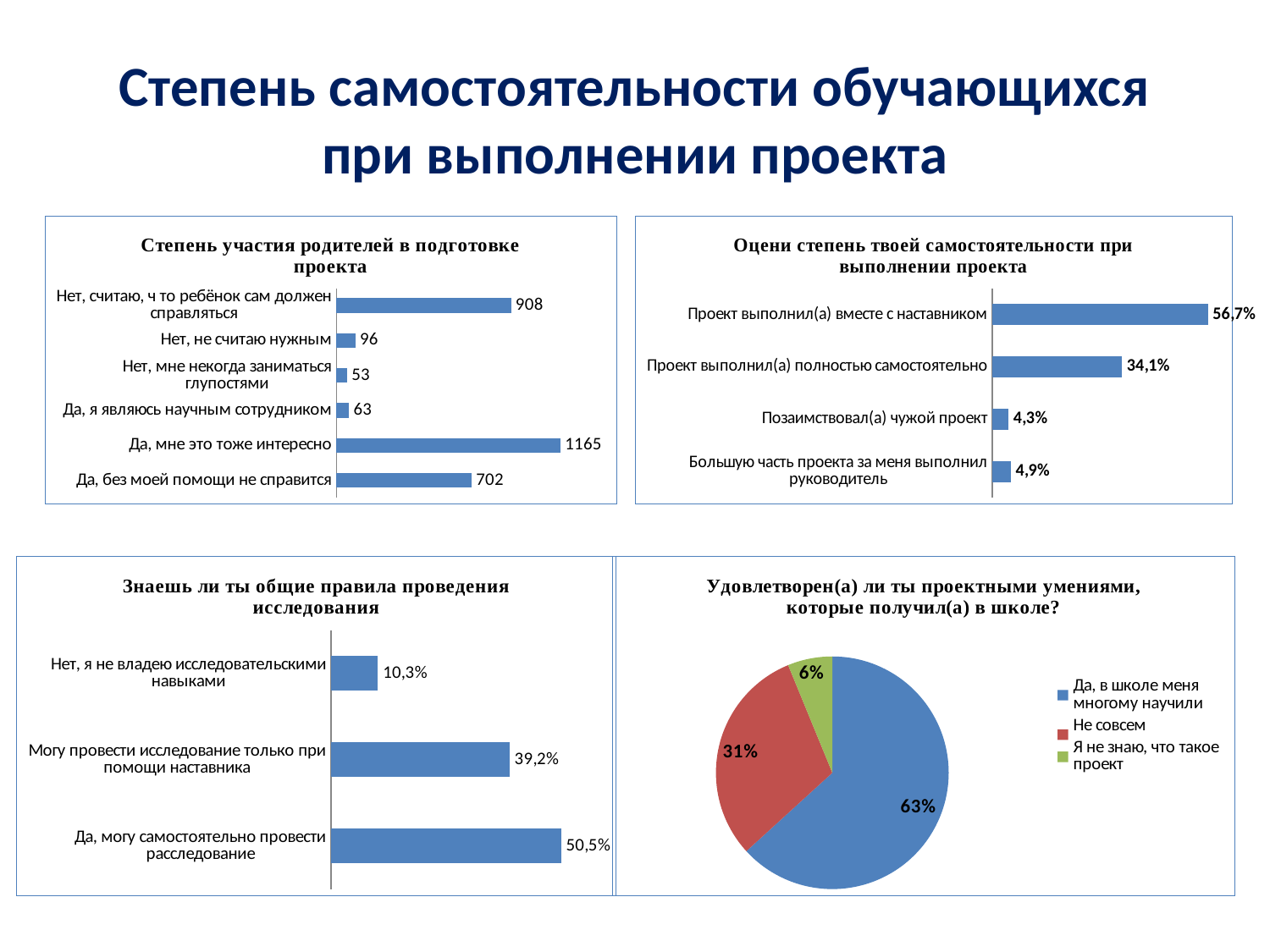
What type of chart is 'Знаешь ли ты общие правила проведения исследования'? Bar chart In the chart 'Степень участия родителей в подготовке проекта', what is the value for 'Да, мне это тоже интересно'? 1165 In the chart 'Знаешь ли ты общие правила проведения исследования', what is the value for 'Могу провести исследование только при помощи наставника'? 39,2% In the chart 'Оцени степень твоей самостоятельности при выполнении проекта', what is the value for 'Проект выполнил(а) полностью самостоятельно'? 34,1% In the chart 'Степень участия родителей в подготовке проекта', what is the difference between 'Да, мне это тоже интересно' and 'Да, без моей помощи не справится'? 463 How many entries does the legend of the pie chart 'Удовлетворен(а) ли ты проектными умениями, которые получил(а) в школе?' list? 3 In the chart 'Степень участия родителей в подготовке проекта', which category has the lowest value? Нет, мне некогда заниматься глупостями In the chart 'Оцени степень твоей самостоятельности при выполнении проекта', which category has the highest value? Проект выполнил(а) вместе с наставником How many categories are shown in the chart 'Степень участия родителей в подготовке проекта'? 6 In the pie chart 'Удовлетворен(а) ли ты проектными умениями, которые получил(а) в школе?', what share does 'Не совсем' have? 31% In the chart 'Оцени степень твоей самостоятельности при выполнении проекта', which is larger: 'Позаимствовал(а) чужой проект' or 'Большую часть проекта за меня выполнил руководитель'? Большую часть проекта за меня выполнил руководитель In the chart 'Знаешь ли ты общие правила проведения исследования', what is the difference between 'Да, могу самостоятельно провести расследование' and 'Нет, я не владею исследовательскими навыками'? 40,2%